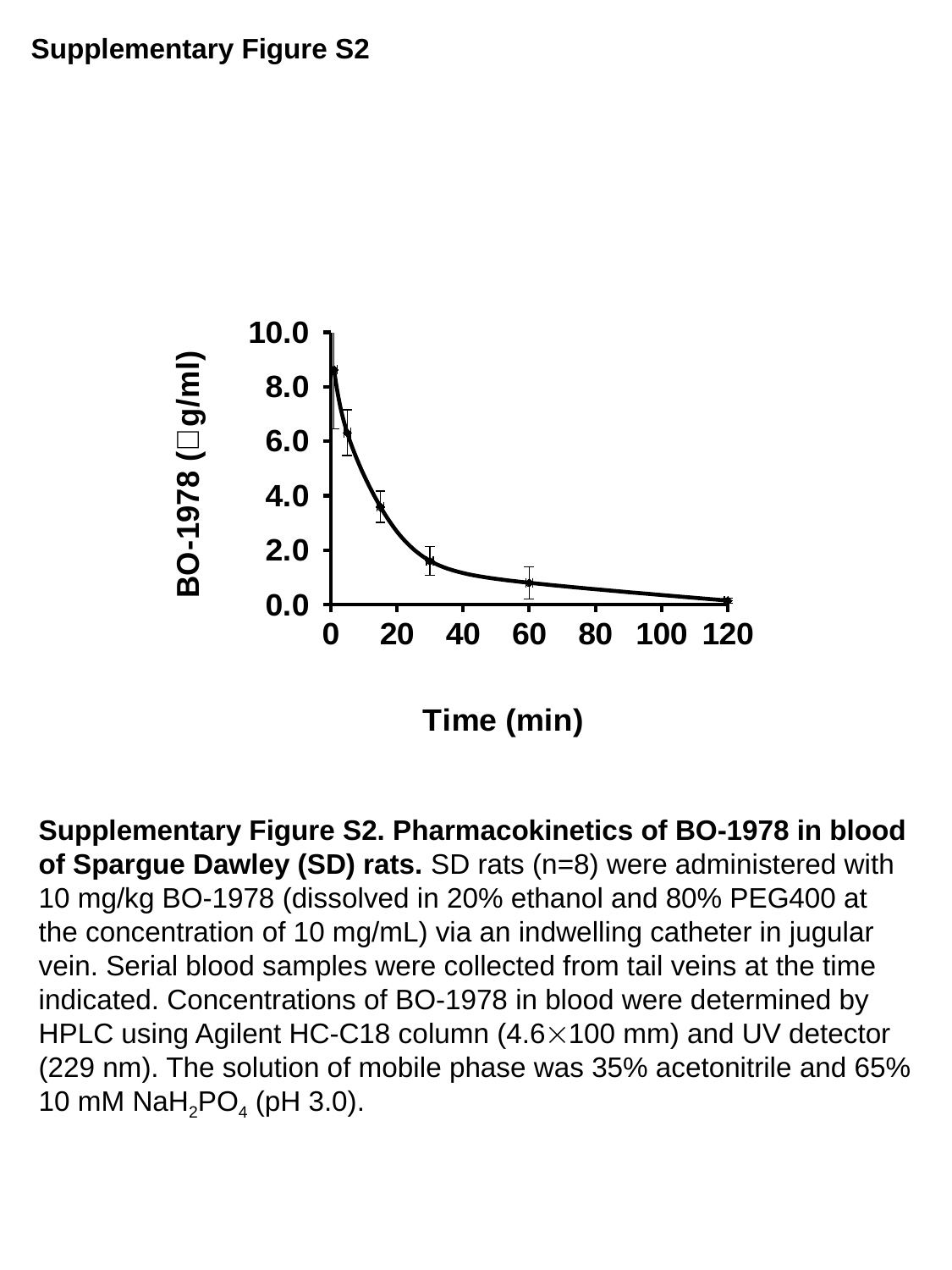
What is the maximum value shown on the y axis? 10.0 Is the BO-1978 concentration at 60 min greater or less than 2.0 µg/ml? less Which is larger, the BO-1978 concentration at 5 min or at 30 min? 5 min At which time point is the BO-1978 concentration lowest? 120 min Is the BO-1978 concentration at 120 min greater or less than 2.0 µg/ml? less Is the BO-1978 concentration at 30 min greater or less than 2.0 µg/ml? less What is the label of the x axis? Time (min) Do the BO-1978 concentration values rise or fall as time increases along the x axis? fall What kind of chart is shown on the slide? line chart At which time point is the BO-1978 concentration highest? 0 min